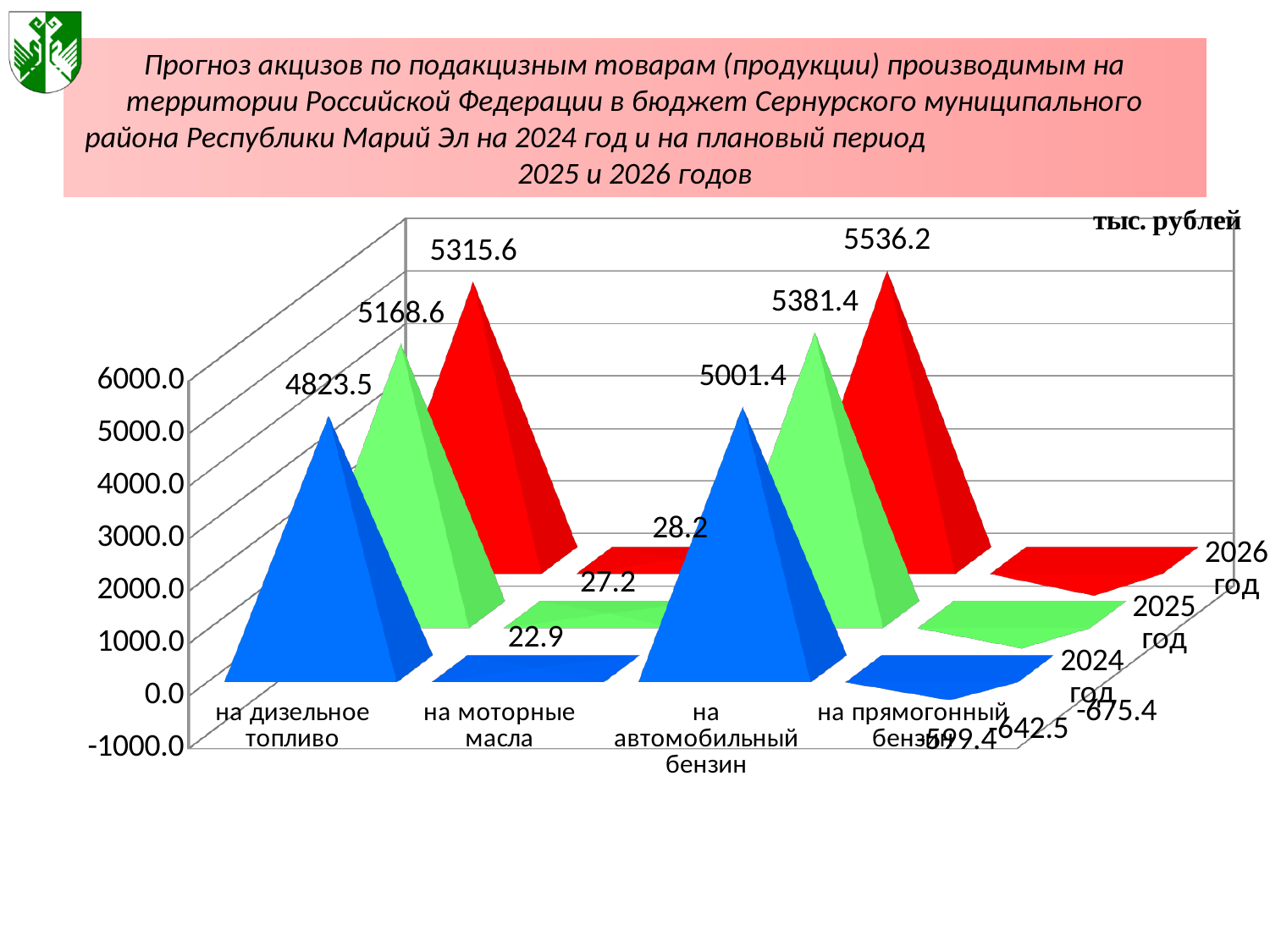
Which is larger: the 2025 год value for на автомобильный бензин or the 2025 год value for на дизельное топливо? на автомобильный бензин What is the value for на моторные масла in 2025 год? 27.2 What is the value for на дизельное топливо in 2024 год? 4823.5 How many categories are shown on the x axis? 4 Do the values for на моторные масла rise or fall from 2024 год to 2026 год? rise How many series (years) does the chart show? 3 What is the value for на автомобильный бензин in 2026 год? 5536.2 Which category has the lowest value in 2025 год? на прямогонный бензин What is the value for на прямогонный бензин in 2026 год? -675.4 What is the difference between the 2026 год and 2024 год values for на дизельное топливо? 492.1 Which category has the highest value in 2026 год? на автомобильный бензин What unit is indicated in the top right corner of the chart? тыс. рублей